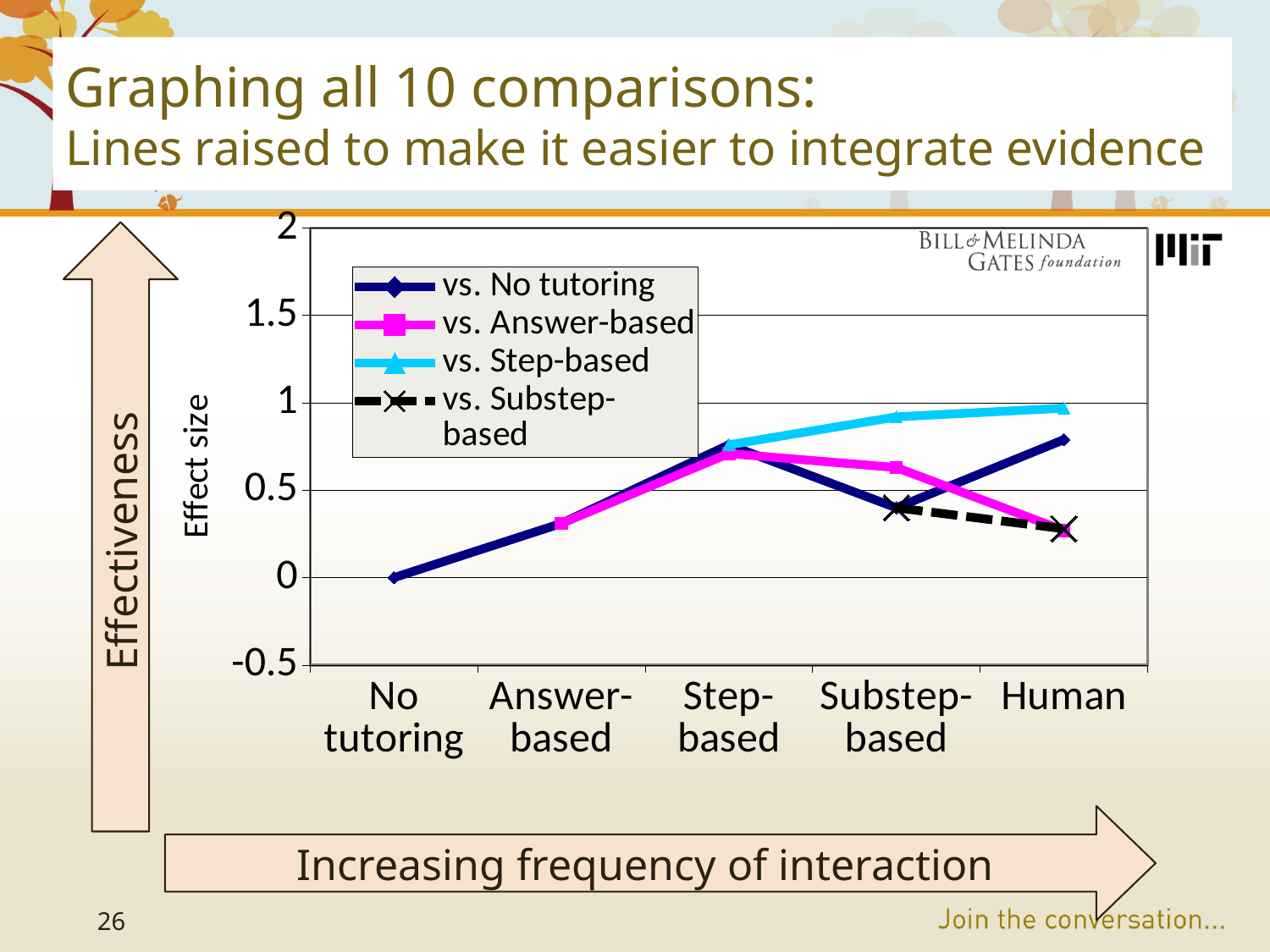
Is the value of the 'vs. Substep-based' series at 'Human' greater or less than 0.5? less Does the 'vs. Substep-based' series rise or fall from 'Substep-based' to 'Human'? fall What kind of chart is shown on the slide? line chart How many series does the chart legend list? 4 At the 'Human' category, which series has the higher value: 'vs. Step-based' or 'vs. Substep-based'? vs. Step-based Is the value of the 'vs. Step-based' series at 'Human' greater or less than 0.5? greater At the 'Substep-based' category, which series has the higher value: 'vs. Step-based' or 'vs. No tutoring'? vs. Step-based How many categories are shown along the x axis of the chart? 5 Is the value of the 'vs. No tutoring' series at 'Human' greater or less than 1? less What is the label of the chart's y axis? Effect size What is the effect size for the 'vs. No tutoring' series at the 'No tutoring' category? 0 Which series has the highest value at the 'Human' category? vs. Step-based